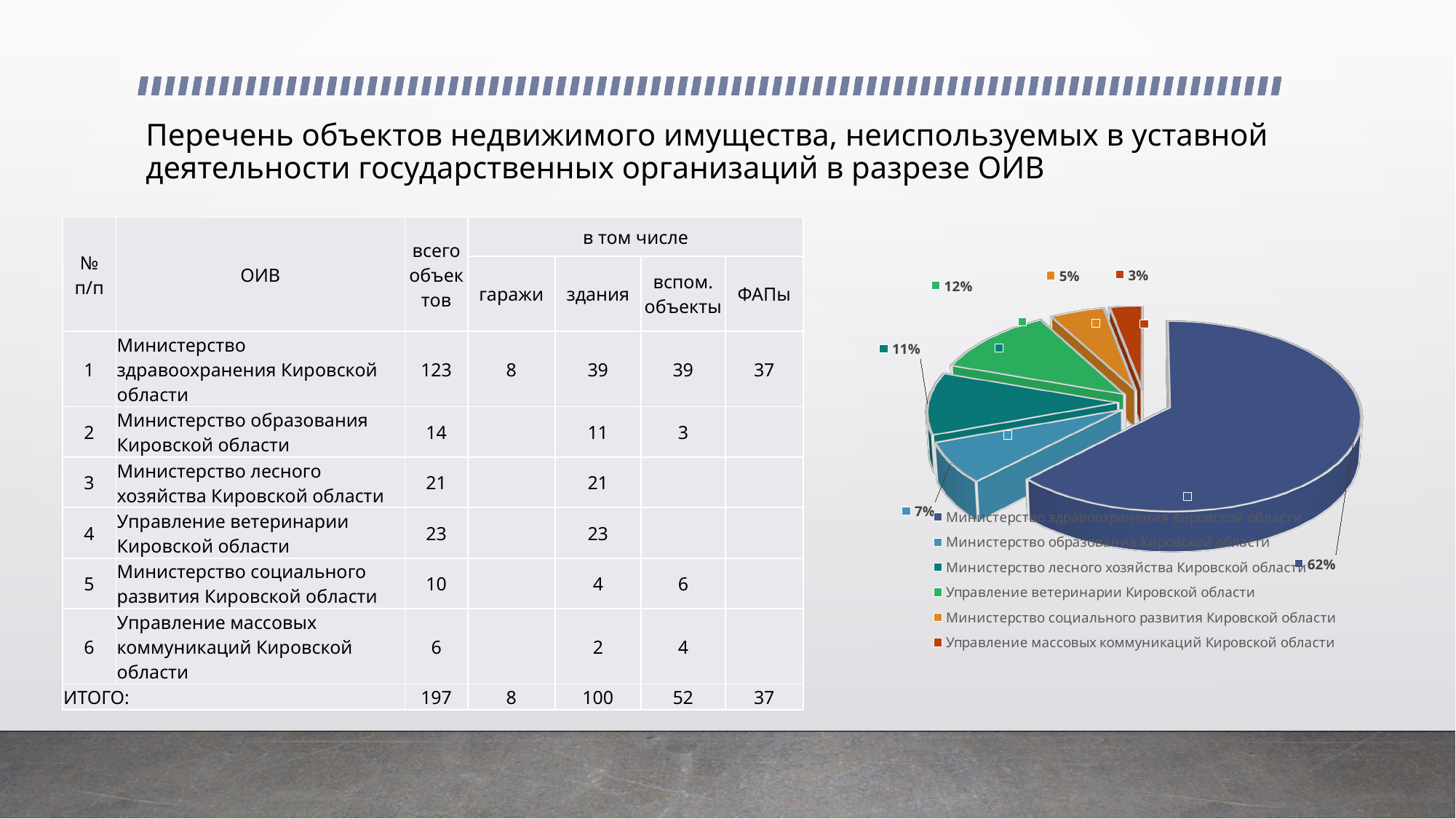
What is the difference in percentage points between the slices for Министерство здравоохранения Кировской области and Министерство образования Кировской области? 55% What percentage is shown for Министерство социального развития Кировской области in the pie chart? 5% What percentage is shown for Министерство лесного хозяйства Кировской области in the pie chart? 11% Which slice is larger in the pie chart: Управление ветеринарии Кировской области or Министерство социального развития Кировской области? Управление ветеринарии Кировской области Which category has the largest slice in the pie chart? Министерство здравоохранения Кировской области What percentage is shown for Министерство образования Кировской области in the pie chart? 7% Which category has the smallest slice in the pie chart? Управление массовых коммуникаций Кировской области How many slices does the pie chart have? 6 What kind of chart is shown on the right side of the slide? pie chart What percentage is shown for Управление ветеринарии Кировской области in the pie chart? 12% How many entries does the pie chart legend list? 6 What share of the pie chart does Министерство здравоохранения Кировской области have? 62%